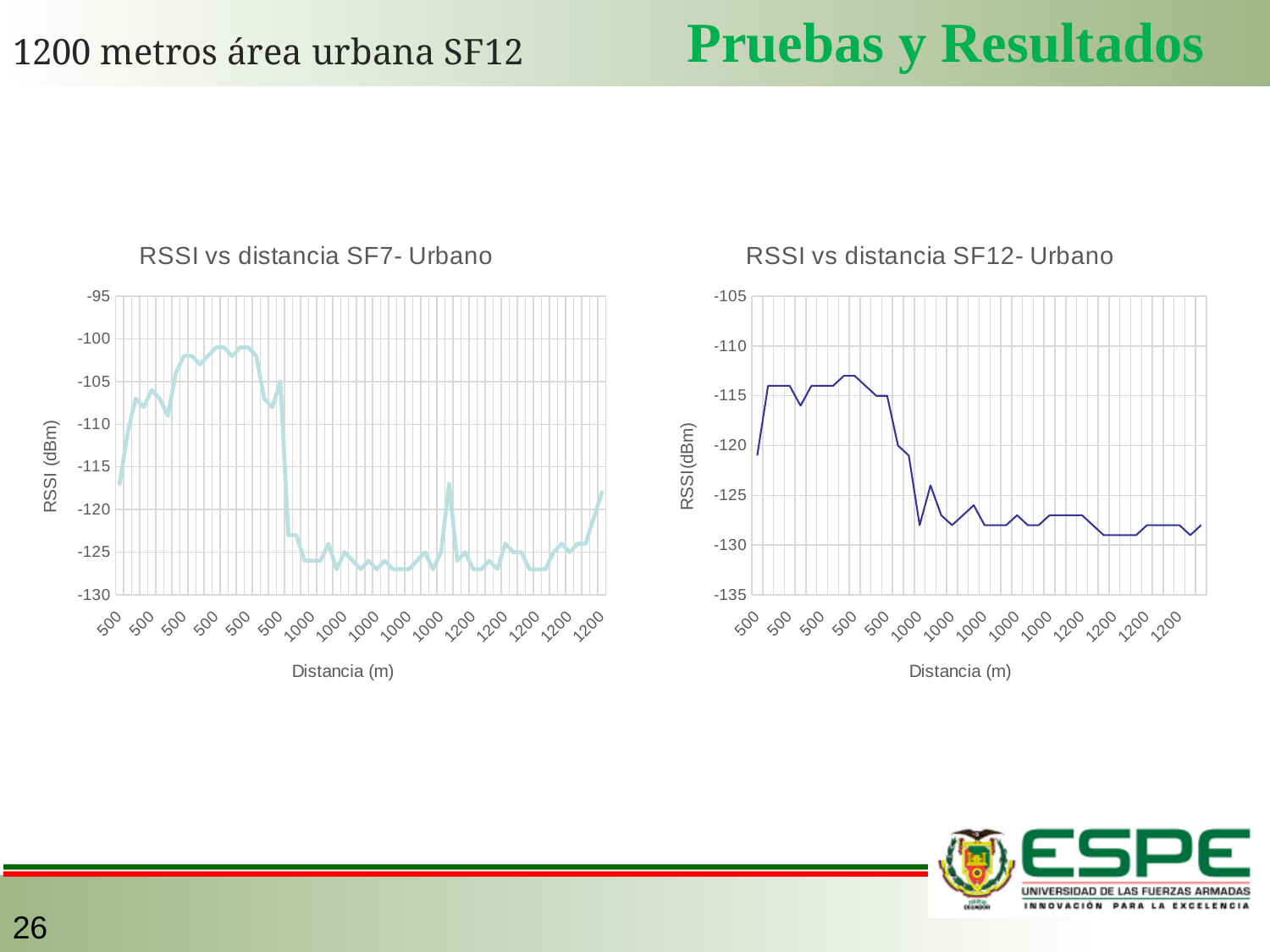
What is the x-axis label of the chart titled "RSSI vs distancia SF12- Urbano"? Distancia (m) In the chart titled "RSSI vs distancia SF12- Urbano", do the values overall rise or fall from the left of the x axis to the right? fall In the chart titled "RSSI vs distancia SF7- Urbano", is the lowest plotted value greater or less than -125? less In the chart titled "RSSI vs distancia SF7- Urbano", is the highest plotted value greater or less than -105? greater In the chart titled "RSSI vs distancia SF7- Urbano", do the values overall rise or fall from the left of the x axis to the right? fall In the chart titled "RSSI vs distancia SF12- Urbano", is the highest plotted value greater or less than -115? greater What is the title of the chart on the left side of the slide? RSSI vs distancia SF7- Urbano What kind of chart is the chart titled "RSSI vs distancia SF12- Urbano"? line chart What kind of chart is the chart titled "RSSI vs distancia SF7- Urbano"? line chart